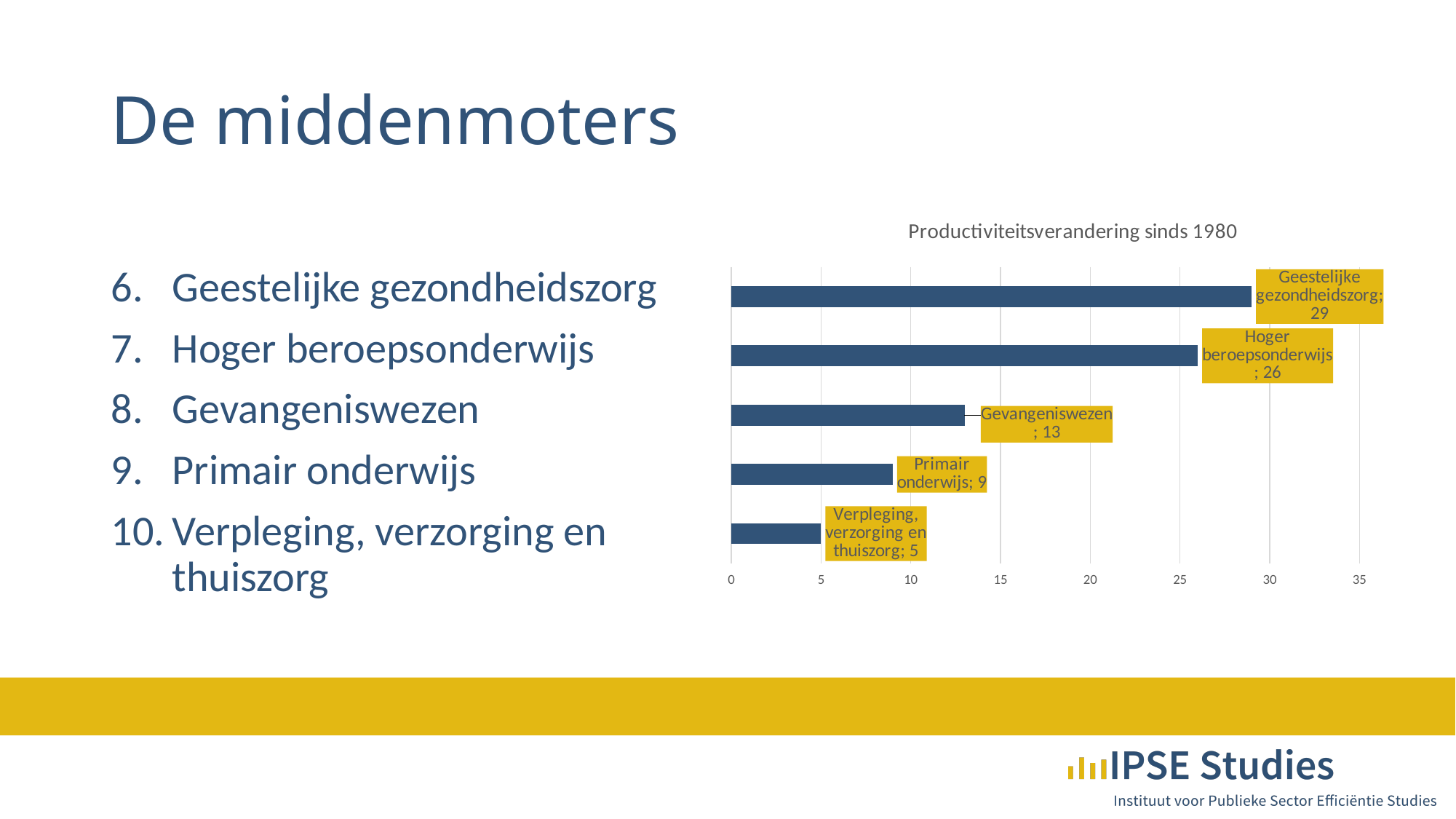
What is the value for Primair onderwijs? 9 Which is larger, the value for Gevangeniswezen or the value for Primair onderwijs? Gevangeniswezen What kind of chart is shown on the slide? Bar chart What is the title of the chart? Productiviteitsverandering sinds 1980 What is the value for Geestelijke gezondheidszorg? 29 What is the value for Hoger beroepsonderwijs? 26 Which category has the lowest value? Verpleging, verzorging en thuiszorg Which category has the highest value? Geestelijke gezondheidszorg What is the value for Verpleging, verzorging en thuiszorg? 5 What is the value for Gevangeniswezen? 13 What is the difference between the values for Geestelijke gezondheidszorg and Hoger beroepsonderwijs? 3 How many categories are shown in the chart? 5